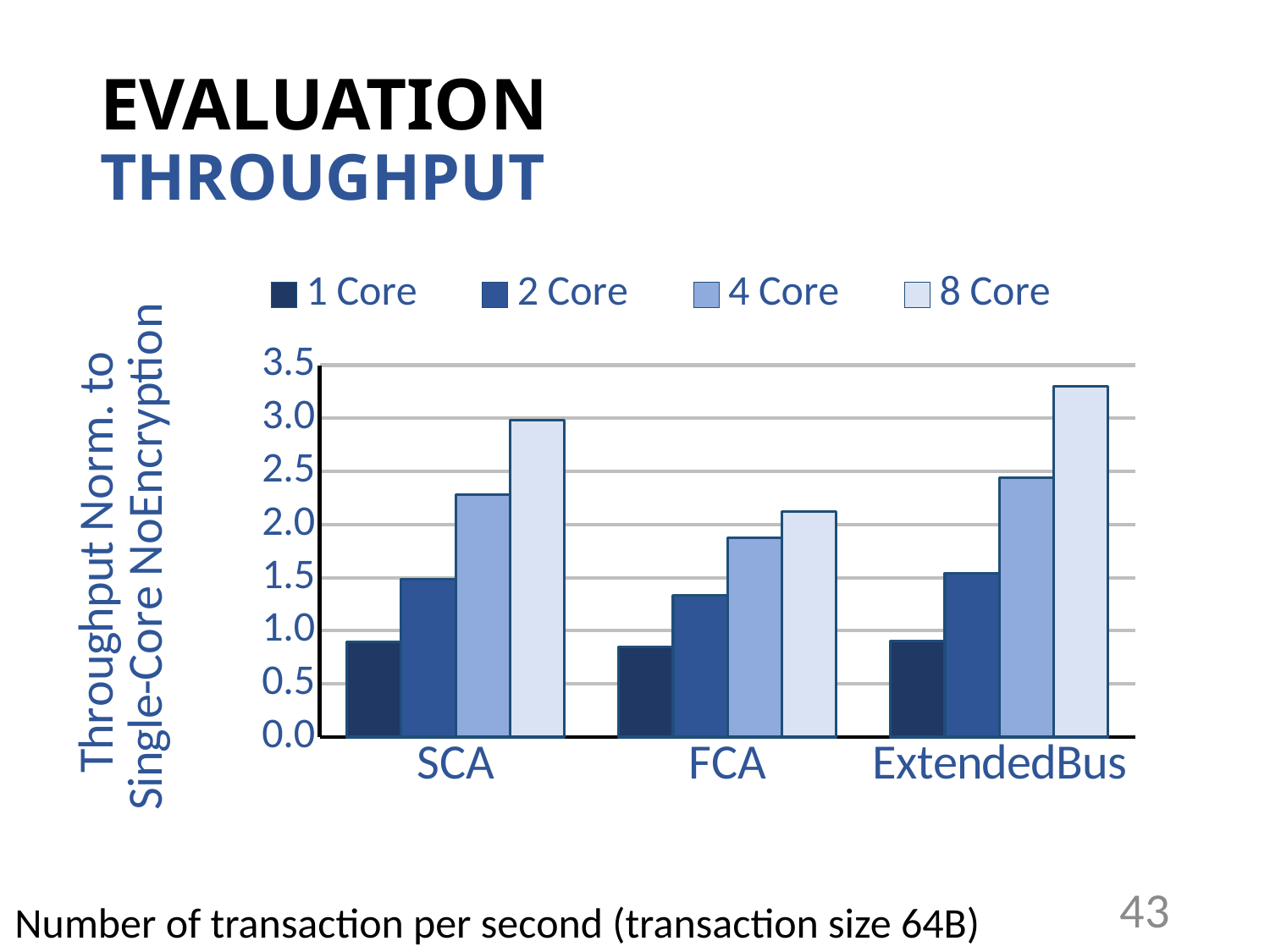
Is the 2 Core value for FCA greater or less than 1.5? less What kind of chart is shown on the slide? bar chart Is the 8 Core value for FCA greater or less than 2.5? less Is the 8 Core value for ExtendedBus greater or less than 3.0? greater How many categories are shown on the x axis? 3 How many series does the legend list? 4 Within each category, do the values rise or fall as the number of cores increases from 1 Core to 8 Core? rise Which is larger, the 4 Core value for SCA or the 4 Core value for FCA? SCA What is the y-axis title of the chart? Throughput Norm. to Single-Core NoEncryption Which category has the lowest 8 Core value? FCA Which category has the highest 8 Core value? ExtendedBus